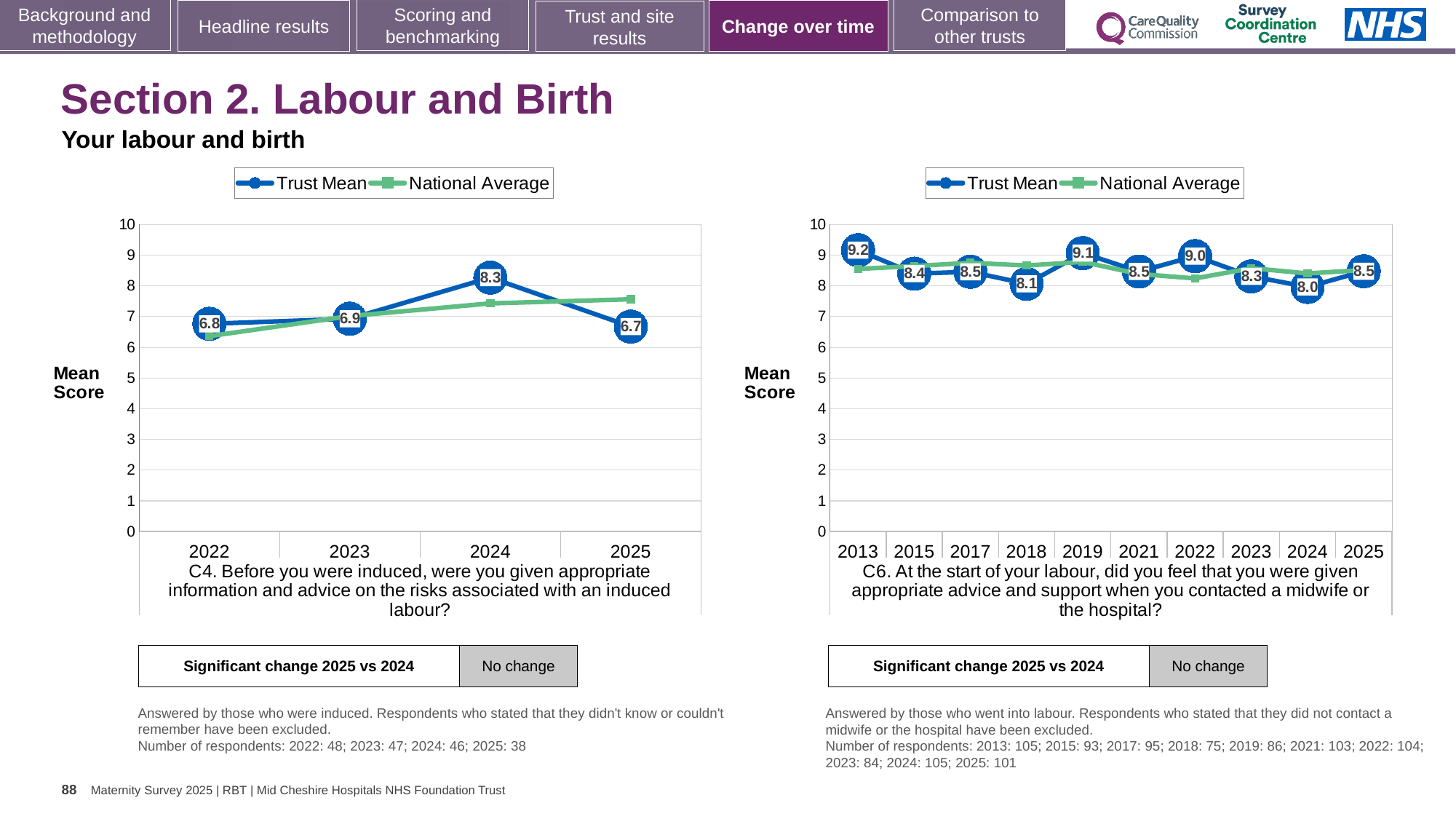
In the right chart (C6), how many years are shown on the x axis? 10 How many series does the legend of the right chart (C6) list? 2 In the left chart (C4), what is the Trust Mean for 2024? 8.3 In the right chart (C6), what is the Trust Mean for 2013? 9.2 What type of chart is the left chart (C4)? Line chart In the left chart (C4), what is the Trust Mean for 2025? 6.7 In the right chart (C6), which year has the lowest Trust Mean? 2024 In the left chart (C4), what is the difference between the Trust Mean for 2024 and 2025? 1.6 In the right chart (C6), is the Trust Mean for 2022 larger than the Trust Mean for 2023? Yes, 2022 (9.0) In the left chart (C4), how many years are shown on the x axis? 4 In the left chart (C4), is the National Average for 2025 greater or less than 7? greater In the left chart (C4), which year has the highest Trust Mean? 2024